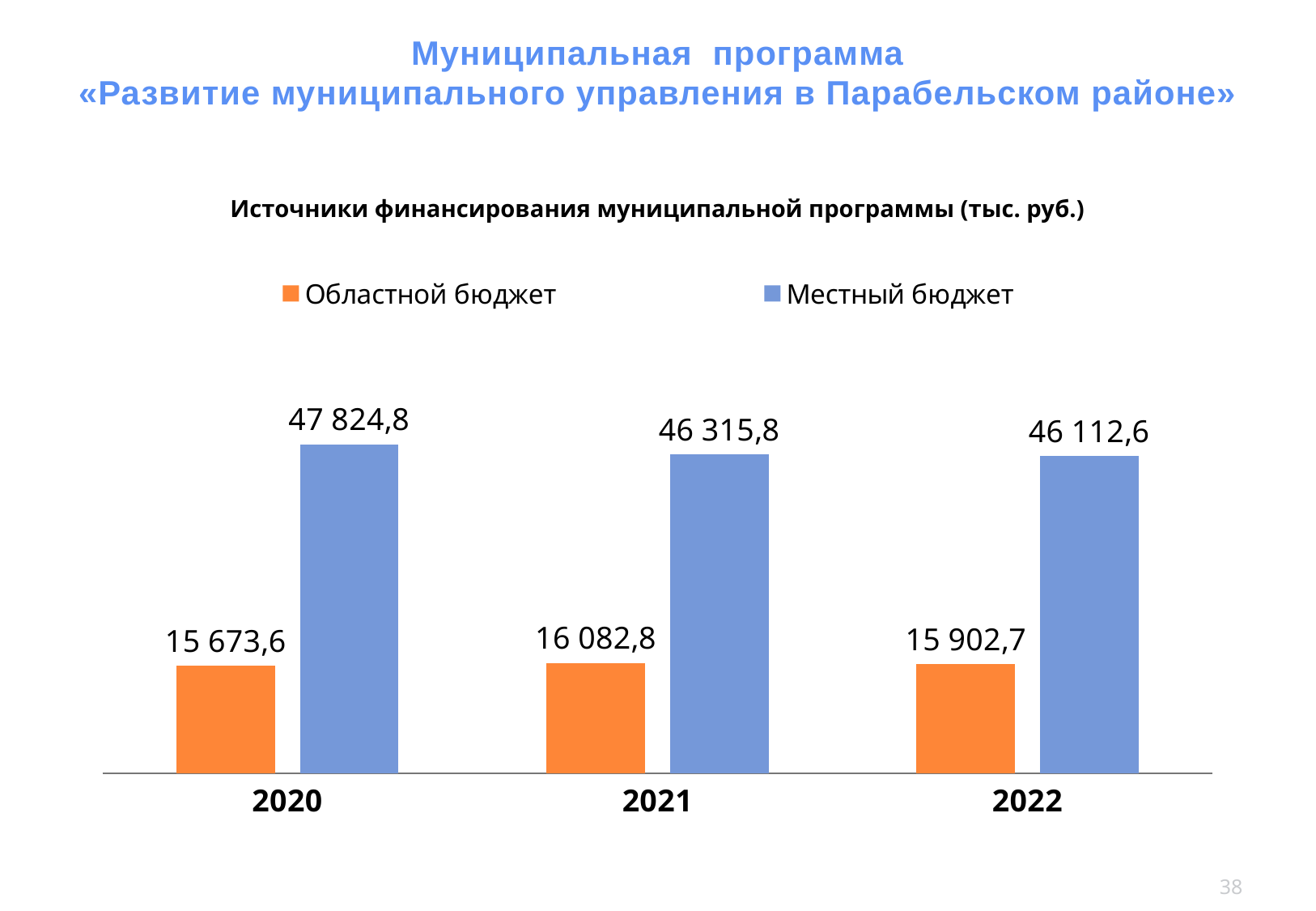
In which year is the Местный бюджет value highest? 2020 What is the difference between Местный бюджет and Областной бюджет in 2020? 32 151,2 In which year is the Областной бюджет value lowest? 2020 By how much did Местный бюджет decrease from 2020 to 2021? 1 509,0 What kind of chart is shown on the slide? Bar chart What is the value for Областной бюджет in 2022? 15 902,7 What is the value for Местный бюджет in 2020? 47 824,8 What is the value for Областной бюджет in 2021? 16 082,8 How many years are shown on the x axis? 3 What is the value for Местный бюджет in 2022? 46 112,6 Which is larger in 2021: Областной бюджет or Местный бюджет? Местный бюджет How many series does the legend list? 2